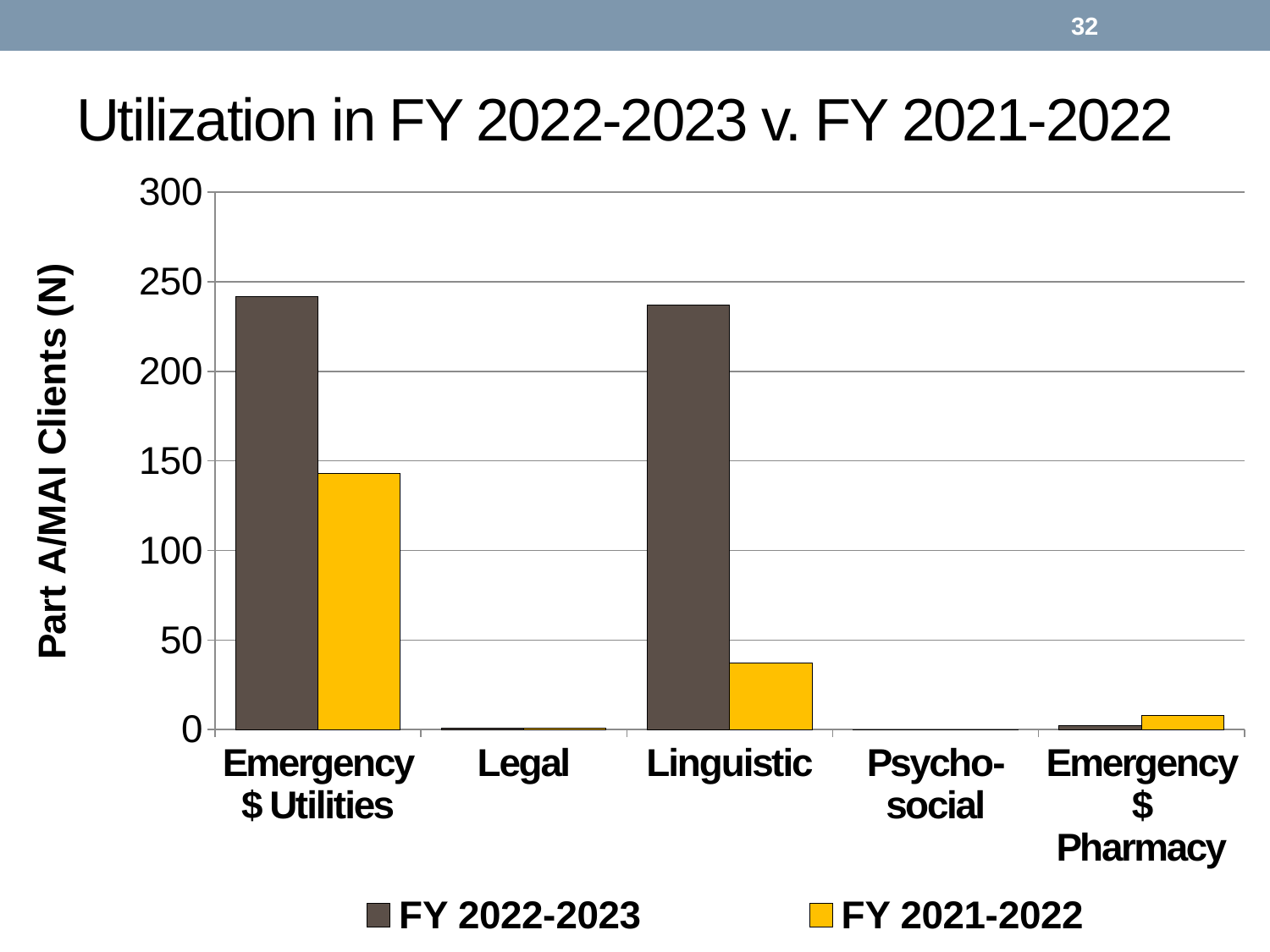
Is the FY 2022-2023 value for Linguistic greater or less than 200? greater What kind of chart is shown on the slide? bar chart Is the FY 2021-2022 value for Emergency $ Utilities greater or less than 150? less For Emergency $ Pharmacy, which series has the larger value, FY 2022-2023 or FY 2021-2022? FY 2021-2022 Is the FY 2022-2023 value for Emergency $ Utilities greater or less than 200? greater How many categories are shown on the x axis? 5 What is the title of the chart? Utilization in FY 2022-2023 v. FY 2021-2022 What is the label on the y axis? Part A/MAI Clients (N) How many series does the legend list? 2 For Linguistic, which series has the larger value, FY 2022-2023 or FY 2021-2022? FY 2022-2023 Which category has the highest value for FY 2021-2022? Emergency $ Utilities